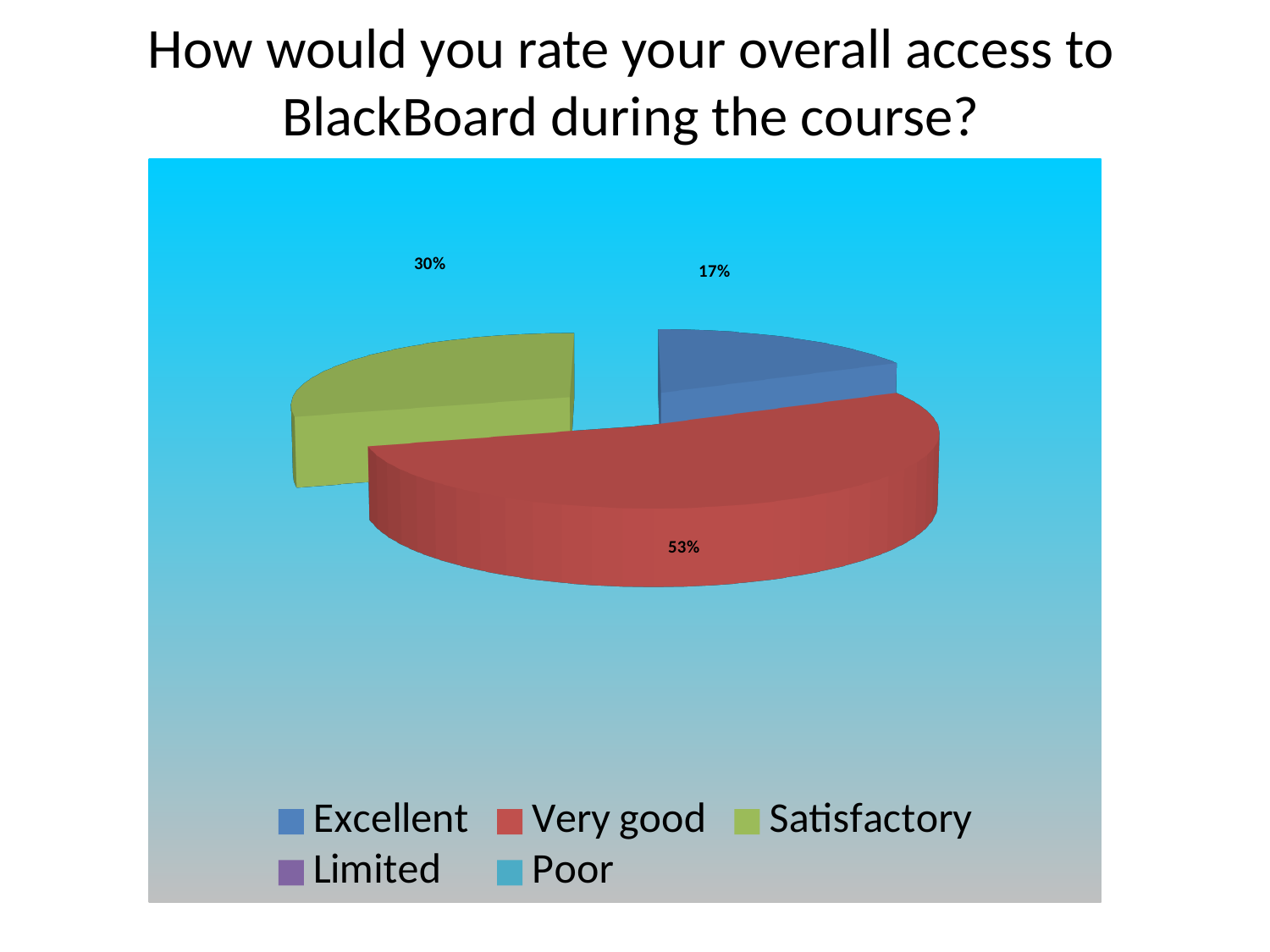
What colour is the Very good slice? red What share of the pie is labelled for Excellent? 17% Which category has the largest slice of the pie? Very good What share of the pie is labelled for Satisfactory? 30% What share of the pie is labelled for Very good? 53% What is the title of the slide above the chart? How would you rate your overall access to BlackBoard during the course? How many categories does the legend list? 5 What is the difference in percentage points between the Very good share and the Satisfactory share? 23 Which is larger, the share for Satisfactory or the share for Excellent? Satisfactory Of the slices with a printed percentage, which category has the smallest share? Excellent What is the difference in percentage points between the Satisfactory share and the Excellent share? 13 What kind of chart is shown on the slide? pie chart